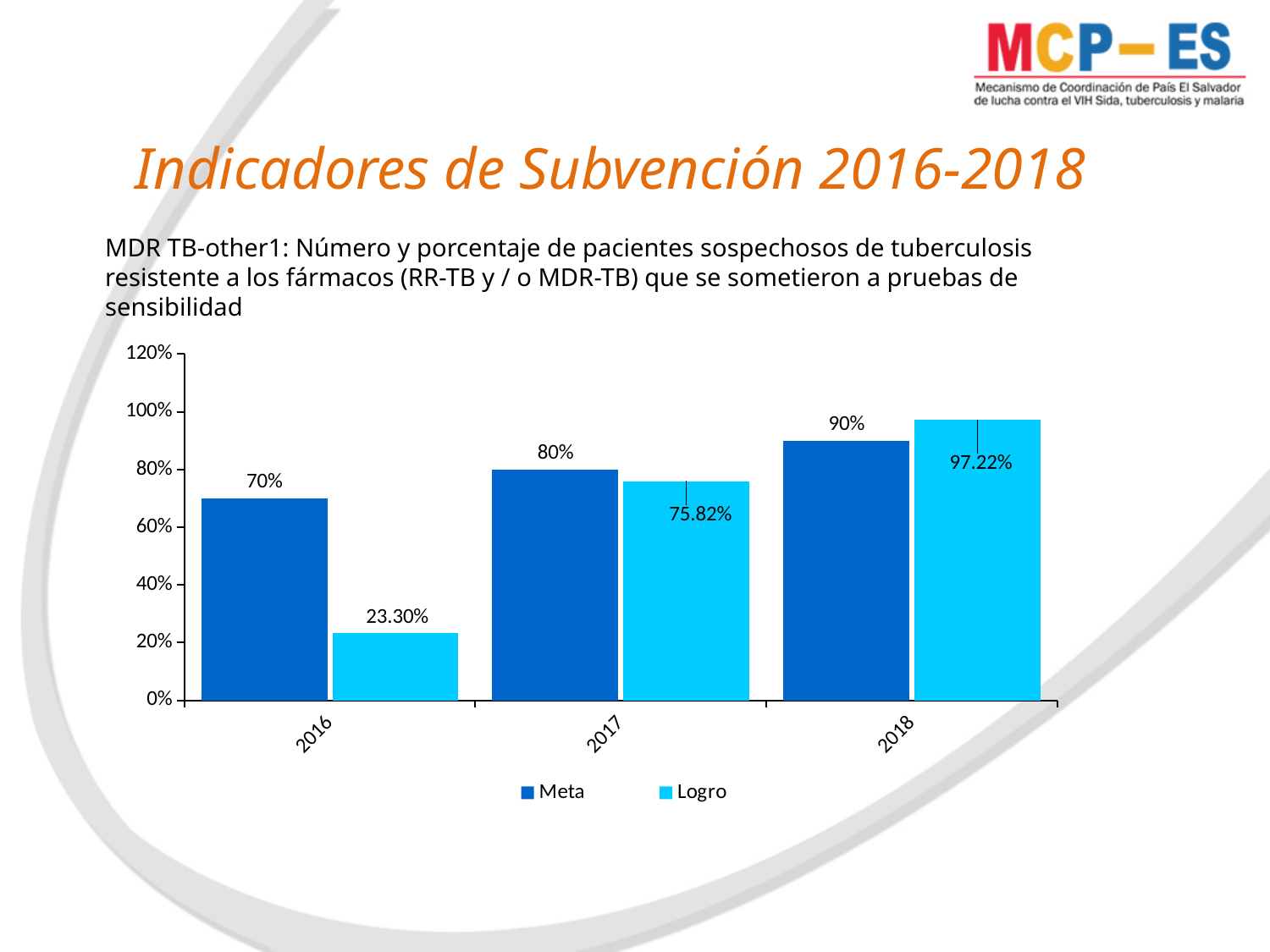
What is the difference between the Meta and Logro values for 2016? 46.70% Is the Logro value for 2017 greater or less than 80%? less How many series does the legend list? 2 Which year has the lowest Logro value? 2016 What is the Logro value for 2016? 23.30% What is the Meta value for 2018? 90% Which year has the highest Logro value? 2018 What is the Logro value for 2017? 75.82% Which is larger for 2018, Meta or Logro? Logro What kind of chart is shown on the slide? bar chart What is the Meta value for 2016? 70% How many years are shown on the x axis? 3